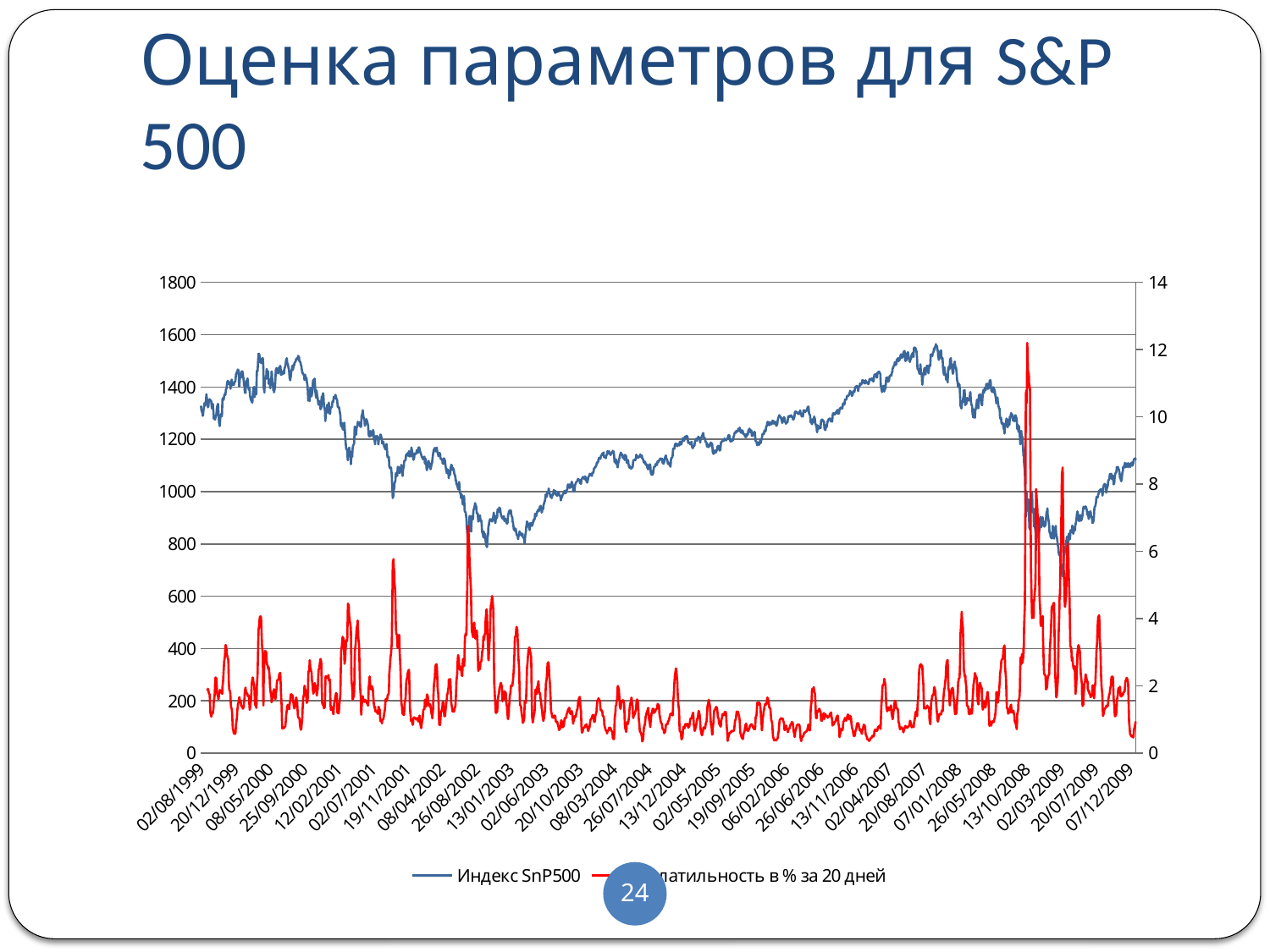
Is the value of Индекс SnP500 at 13/01/2003 greater or less than 1000? less What is the name of the first series in the legend (the blue line)? Индекс SnP500 Is the value of Индекс SnP500 at 02/03/2009 greater or less than 1000? less What kind of chart is shown on the slide? line chart Does the Индекс SnP500 line rise or fall between 13/01/2003 and 20/08/2007? rise Is the highest peak of the red volatility series greater or less than 10 on the right axis? greater How many series does the legend list? 2 Does the Индекс SnP500 line rise or fall between 20/08/2007 and 02/03/2009? fall What is the highest tick value on the left vertical axis? 1800